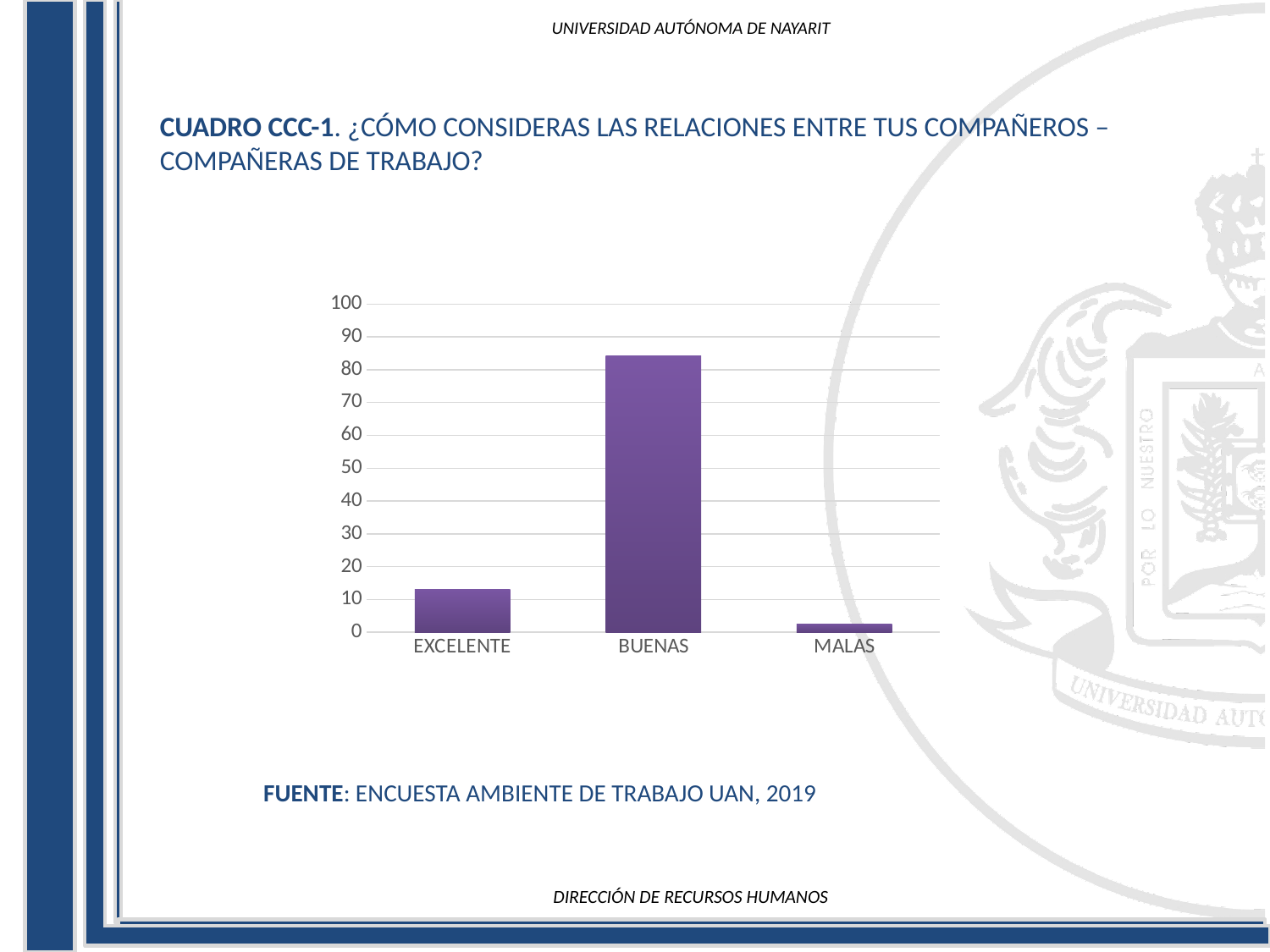
Which category has the highest bar in the chart? BUENAS Which category has the lowest bar in the chart? MALAS Which is larger, the value for BUENAS or the value for EXCELENTE? BUENAS Is the value for MALAS greater or less than 10? less Is the value for BUENAS greater or less than 50? greater How many categories are shown on the x axis of the chart? 3 Which is larger, the value for EXCELENTE or the value for MALAS? EXCELENTE What is the maximum value shown on the vertical axis of the chart? 100 Is the value for BUENAS greater or less than 80? greater According to the slide, what is the source of the chart data? ENCUESTA AMBIENTE DE TRABAJO UAN, 2019 What kind of chart is shown on the slide? bar chart